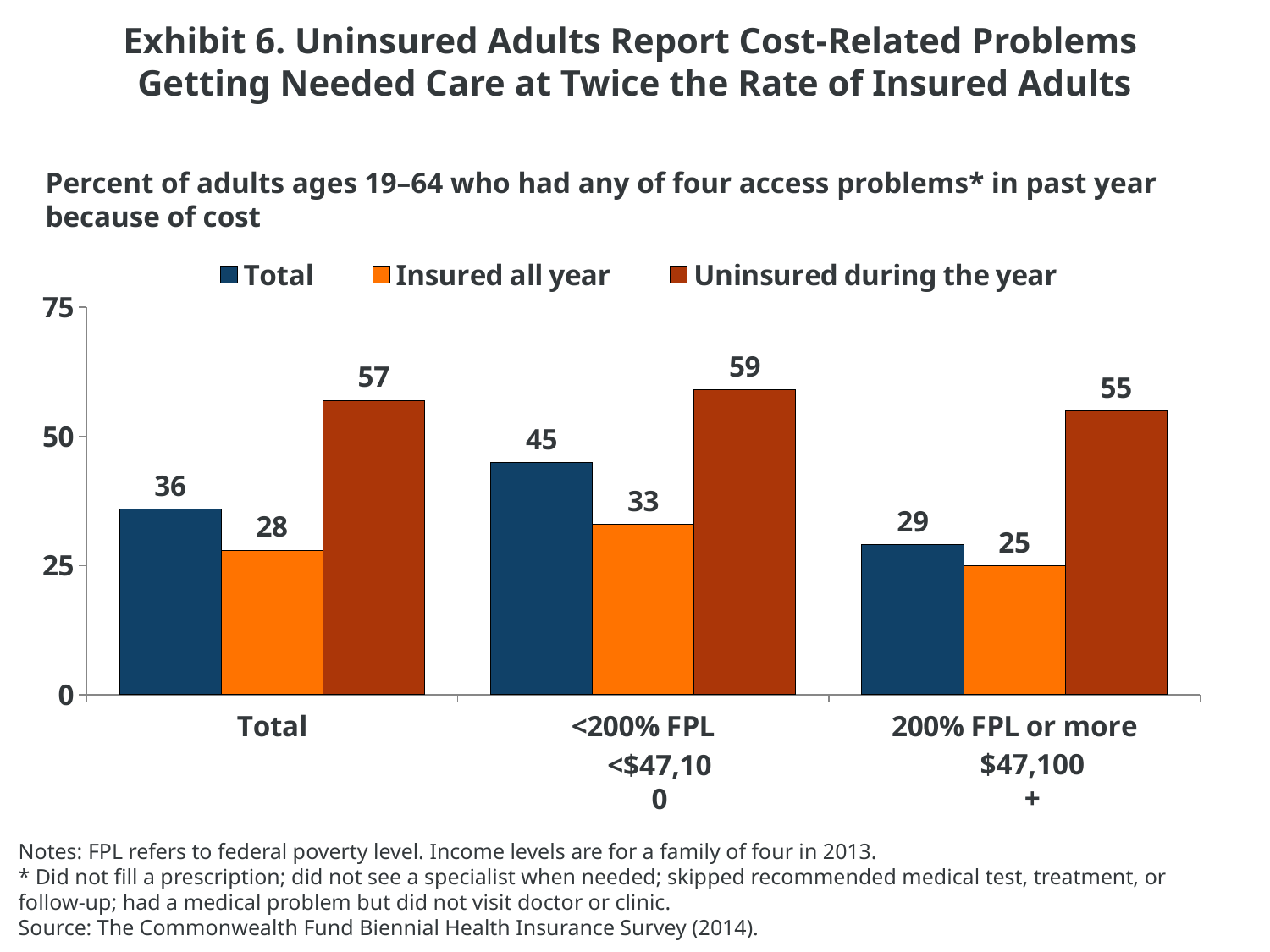
How many categories are shown on the x axis? 3 What is the value for Total in the 200% FPL or more category? 29 What is the value for Insured all year in the <200% FPL category? 33 Which category has the lowest value for Insured all year? 200% FPL or more Which is larger in the <200% FPL category: Total or Insured all year? Total How many series does the legend list? 3 What is the value for Uninsured during the year in the Total category? 57 What is the difference between Uninsured during the year and Insured all year in the Total category? 29 Is the value for Uninsured during the year in the 200% FPL or more category greater or less than 50? greater Which category has the highest value for Uninsured during the year? <200% FPL What kind of chart is shown on the slide? bar chart What colour are the bars for Insured all year? orange